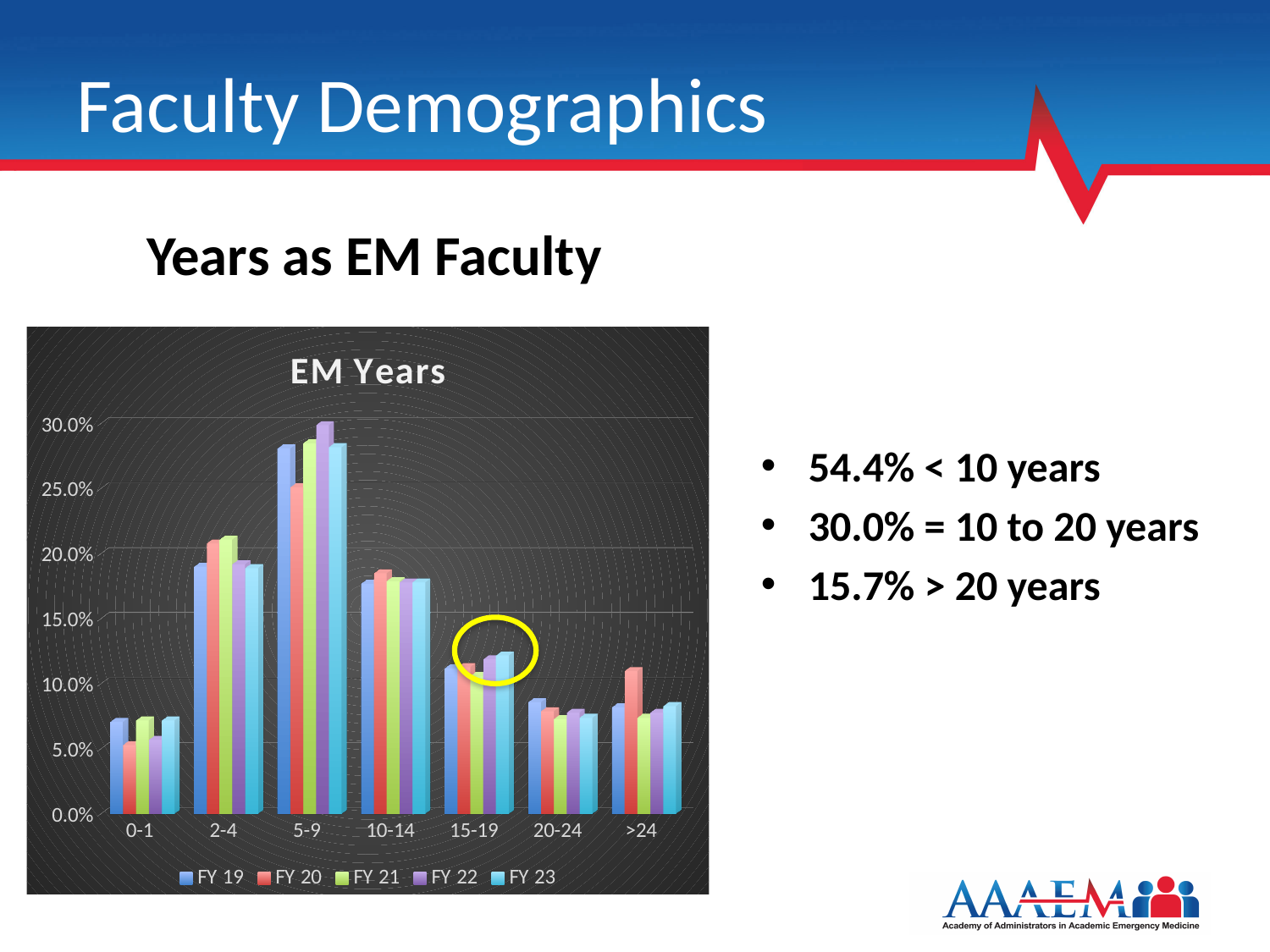
Is the value for FY 19 in the 10-14 category greater or less than 15.0%? greater In the 5-9 category, which is larger: FY 22 or FY 20? FY 22 Is the value for FY 20 in the 0-1 category greater or less than 10.0%? less How many categories are shown on the x axis of the chart? 7 Which category has the highest values in the chart? 5-9 What is the title of the chart? EM Years Is the value for FY 23 in the 20-24 category greater or less than 10.0%? less In the >24 category, which is larger: FY 20 or FY 21? FY 20 Which category has the lowest value for FY 20? 0-1 What kind of chart is shown on the slide? Bar chart How many series does the chart's legend list? 5